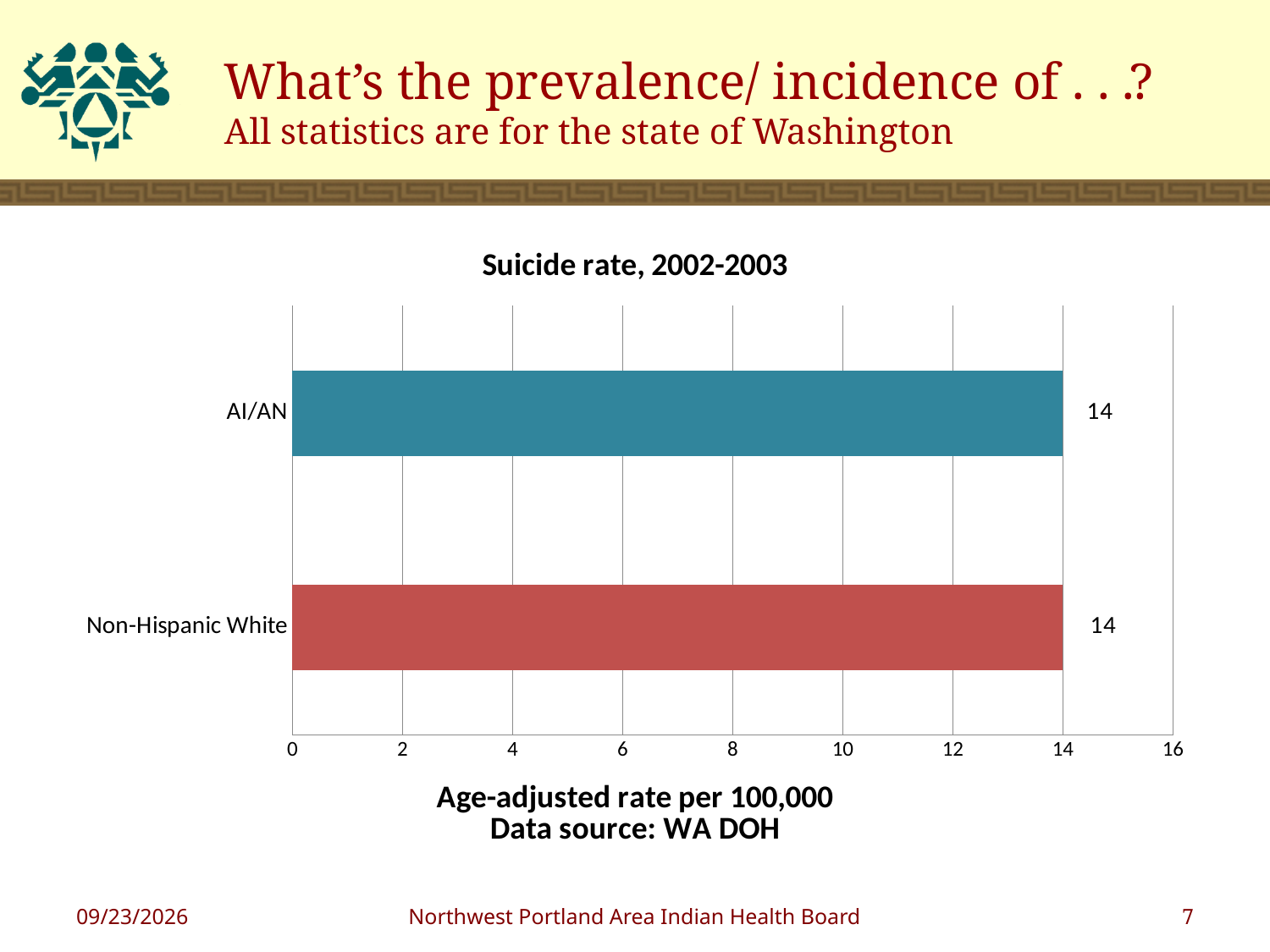
What is the difference between the suicide rate for AI/AN and for Non-Hispanic White? 0 What is the highest value shown on the horizontal axis of the chart? 16 What is the title of the chart? Suicide rate, 2002-2003 What is the suicide rate for AI/AN in the chart? 14 Is the value for Non-Hispanic White greater or less than 16? less What kind of chart is shown on the slide? bar chart What is the label on the horizontal axis of the chart? Age-adjusted rate per 100,000 Data source: WA DOH What is the suicide rate for Non-Hispanic White in the chart? 14 Is the value for AI/AN greater or less than 10? greater How many categories are shown in the chart? 2